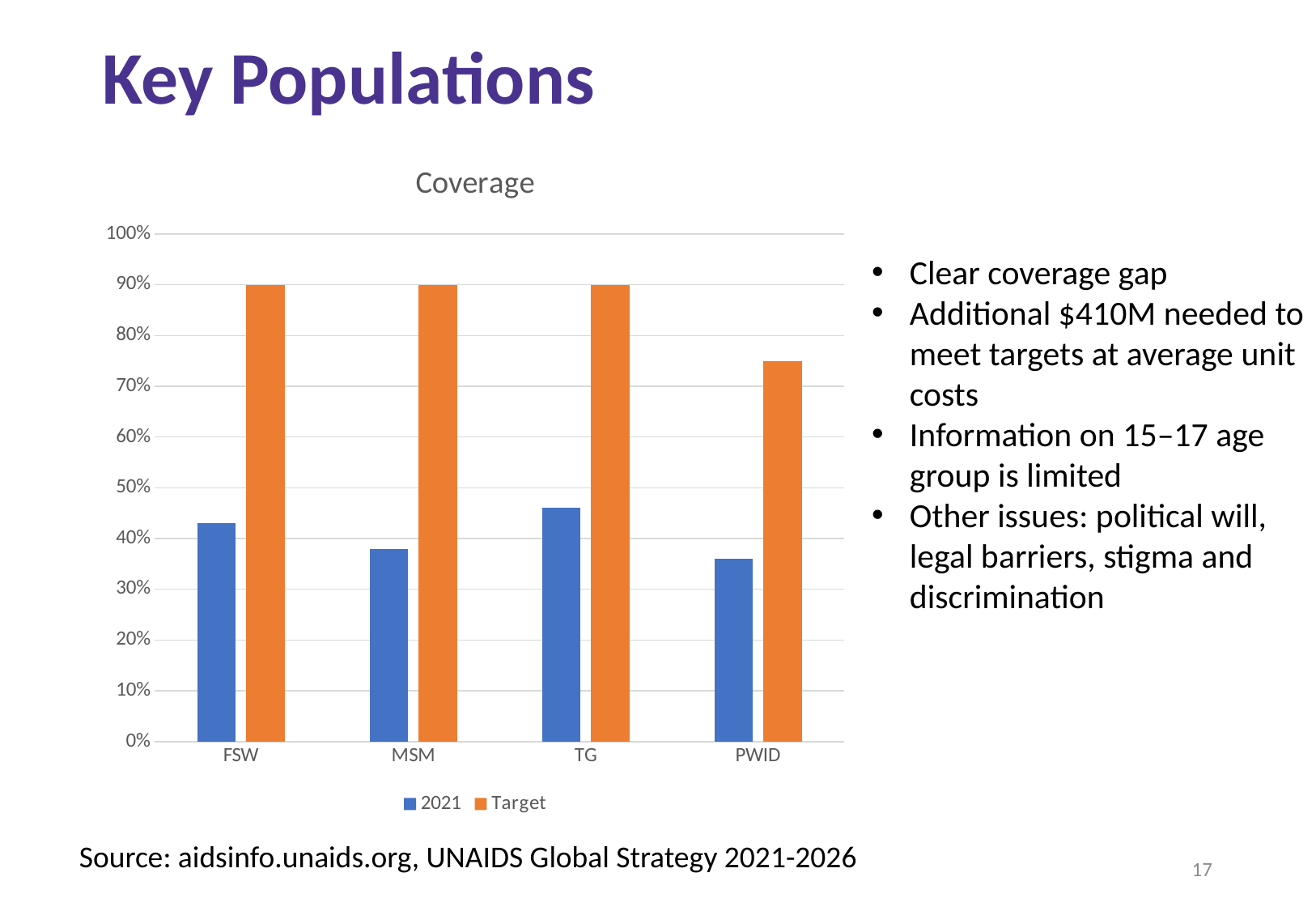
Is the Target value for PWID greater or less than 80%? less How many categories are shown on the x axis? 4 What is the Target value for TG? 90% What is the Target value for FSW? 90% Which is larger, the 2021 value for FSW or the 2021 value for MSM? FSW How many series does the legend list? 2 Is the 2021 value for FSW greater or less than 40%? greater What is the title of the chart? Coverage What kind of chart is shown on the slide? bar chart Which category has the highest 2021 value? TG Which category has the lowest Target value? PWID Is the 2021 value for MSM greater or less than 40%? less